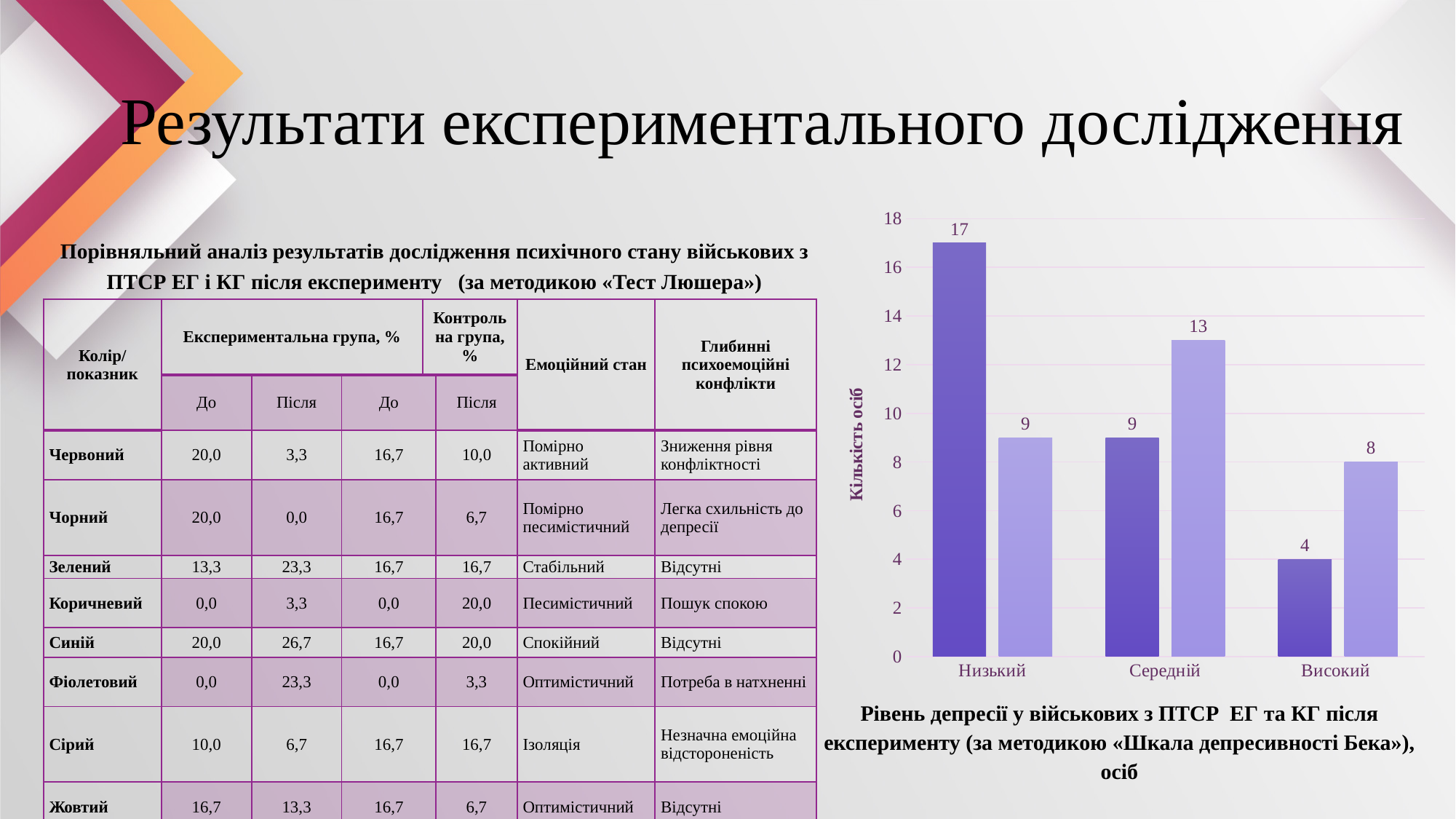
In the bar chart, which is larger for Середній: the darker purple bar or the lighter purple bar? the lighter purple bar What kind of chart is shown on the right side of the slide? bar chart How many categories are shown on the x axis of the bar chart? 3 In the bar chart, what is the value of the darker purple bar for Високий? 4 What is the label of the vertical axis of the bar chart? Кількість осіб In the bar chart, what is the value of the darker purple bar for Низький? 17 In the bar chart, do the darker purple bars rise or fall from Низький to Високий? fall In the bar chart, what is the difference between the darker and lighter purple bars for Низький? 8 In the bar chart, what is the value of the lighter purple bar for Високий? 8 In the bar chart, which category has the tallest bar overall? Низький In the bar chart, what is the value of the lighter purple bar for Середній? 13 In the bar chart, which category has the lowest darker purple bar? Високий